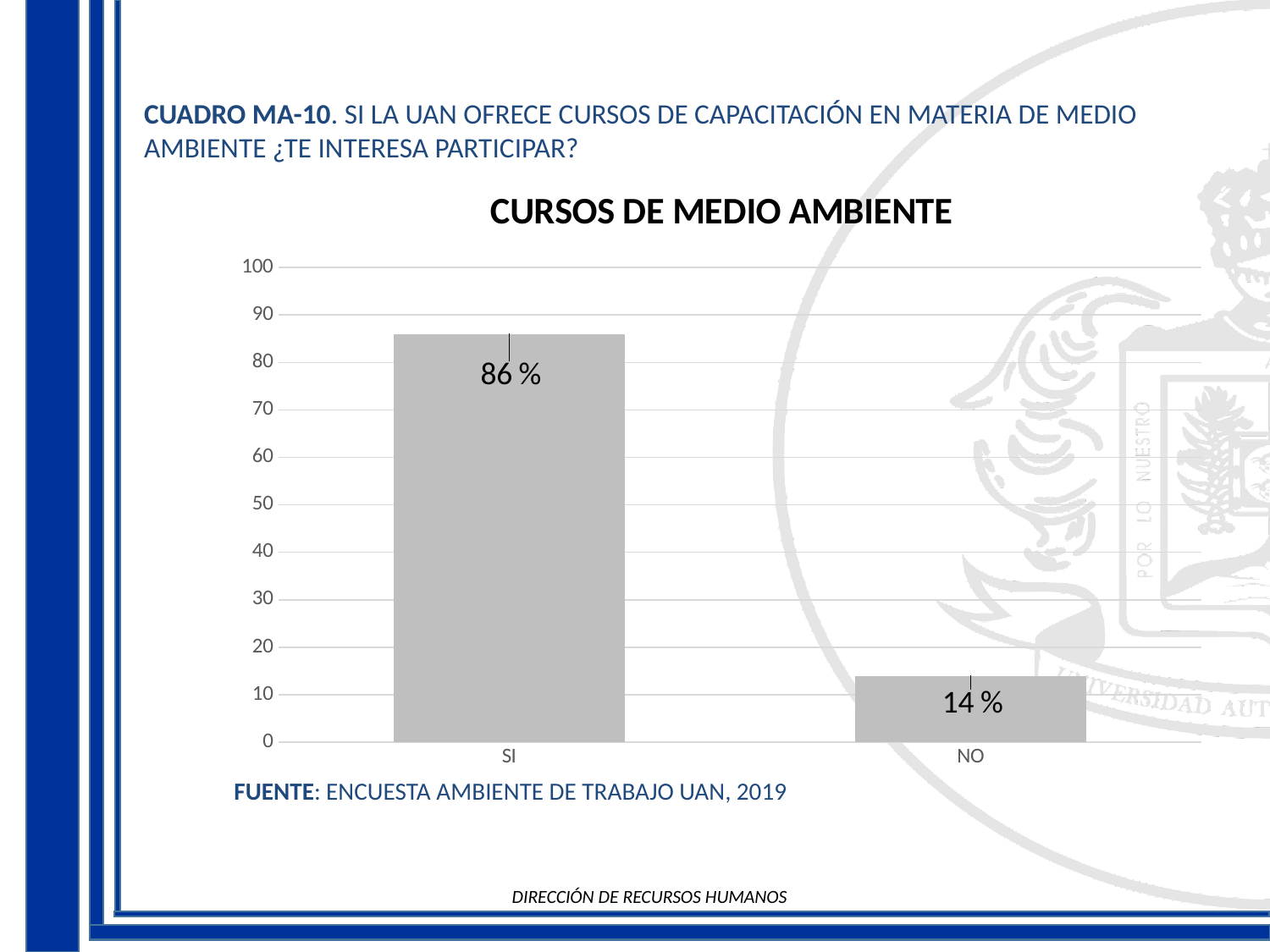
Which is larger, the value for SI or the value for NO? SI Is the value for SI greater or less than 80? greater What is the value for SI? 86 % What is the maximum value shown on the y axis? 100 Which category has the lowest value? NO Is the value for NO greater or less than 20? less What kind of chart is this? bar chart What is the value for NO? 14 % What is the difference between the values for SI and NO? 72 % What is the title of the chart? CURSOS DE MEDIO AMBIENTE Which category has the highest value? SI How many categories are shown on the x axis? 2